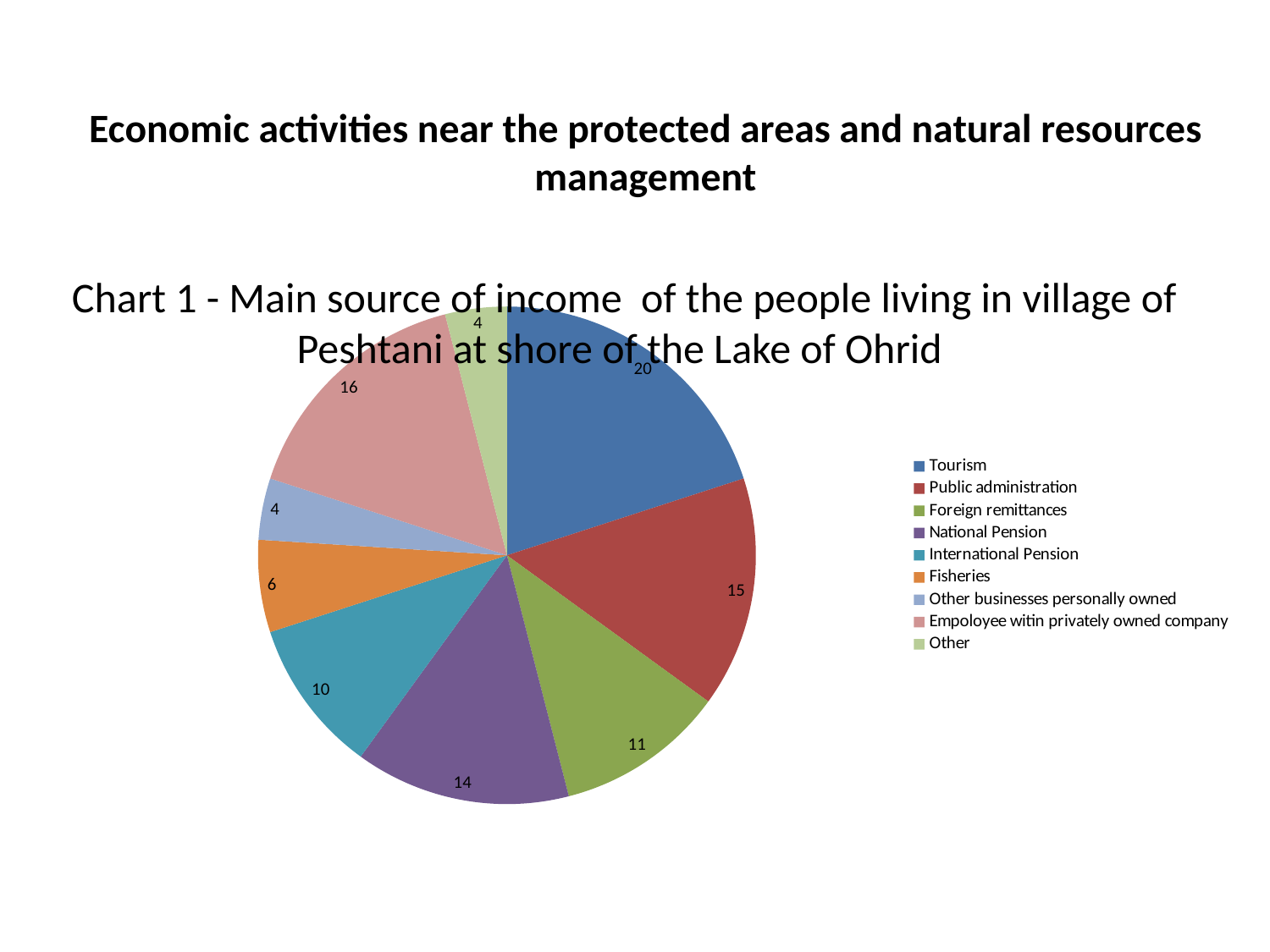
What is the value for Fisheries? 6 What is the value for Public administration? 15 Which is larger, International Pension or Foreign remittances? Foreign remittances What is the difference between the values for National Pension and International Pension? 4 How many categories does the legend list? 9 What is the difference between the values for Tourism and Employee within privately owned company? 4 What is the value for Tourism? 20 What share of the pie does Tourism represent? 20% Which category has the largest slice? Tourism What is the value for National Pension? 14 What kind of chart is shown on the slide? pie chart What is the title of the chart? Chart 1 - Main source of income of the people living in village of Peshtani at shore of the Lake of Ohrid